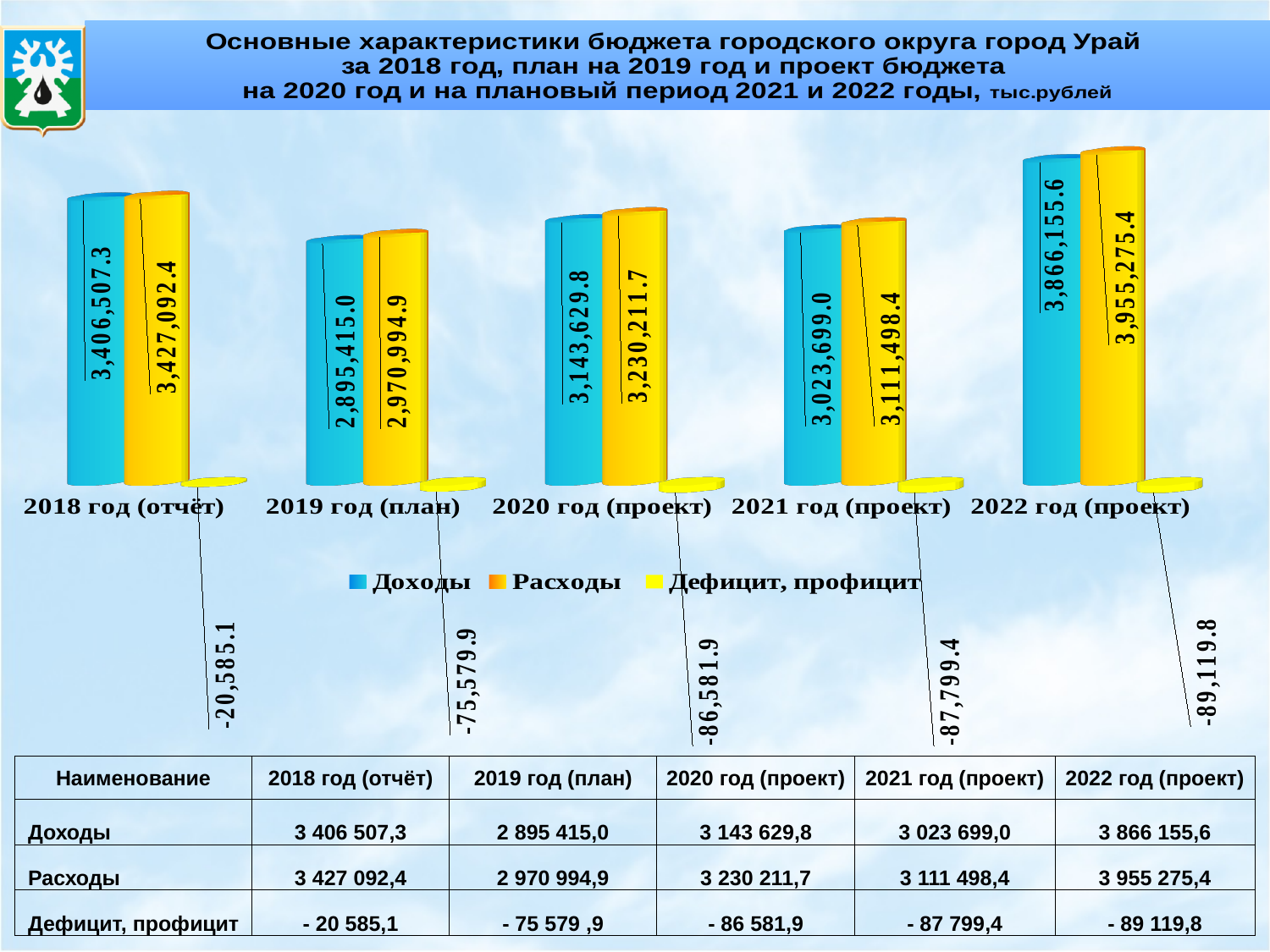
How many year categories are shown on the x axis of the chart? 5 What kind of chart is shown on the slide? bar chart Which year has the highest Доходы value? 2022 год (проект) Which is larger: Доходы for 2020 год (проект) or Доходы for 2021 год (проект)? 2020 год (проект) What is the value of Доходы for 2018 год (отчёт)? 3,406,507.3 What is the value of Расходы for 2022 год (проект)? 3,955,275.4 Which year has the lowest Доходы value? 2019 год (план) Do the Дефицит, профицит values get larger or smaller in magnitude from 2018 to 2022? larger What is the value of Расходы for 2019 год (план)? 2,970,994.9 What is the value of Дефицит, профицит for 2020 год (проект)? -86,581.9 How many series does the chart legend list? 3 By how much do Расходы exceed Доходы in 2021 год (проект)? 87,799.4